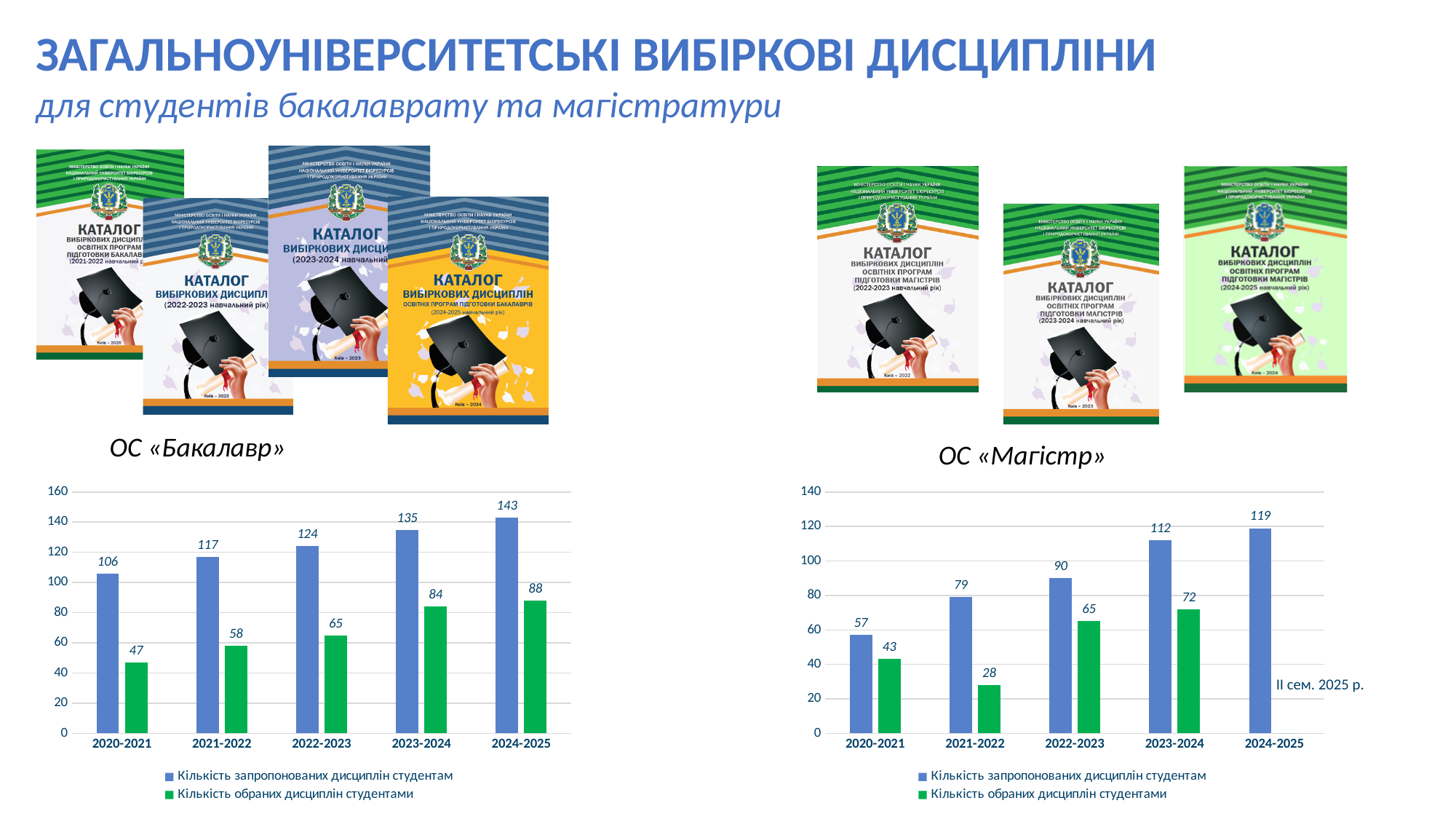
In the ОС «Бакалавр» chart, what is the number of offered disciplines (Кількість запропонованих дисциплін студентам) for 2022-2023? 124 How many series does the legend of the ОС «Бакалавр» chart list? 2 In the ОС «Магістр» chart, what is the number of offered disciplines for 2023-2024? 112 In the ОС «Бакалавр» chart, do the chosen disciplines rise or fall from 2020-2021 to 2024-2025? rise In the ОС «Бакалавр» chart, which academic year has the highest number of offered disciplines? 2024-2025 In the ОС «Магістр» chart, what is the difference between offered and chosen disciplines in 2022-2023? 25 How many academic years are shown on the x axis of the ОС «Магістр» chart? 5 What type of chart is the ОС «Магістр» chart? bar chart Which is larger: the number of offered disciplines for 2024-2025 in the ОС «Бакалавр» chart or in the ОС «Магістр» chart? ОС «Бакалавр» In the ОС «Магістр» chart, which academic year has the lowest number of chosen disciplines? 2021-2022 In the ОС «Бакалавр» chart, what is the number of chosen disciplines (Кількість обраних дисциплін студентами) for 2020-2021? 47 In the ОС «Бакалавр» chart, what is the difference between offered and chosen disciplines in 2024-2025? 55